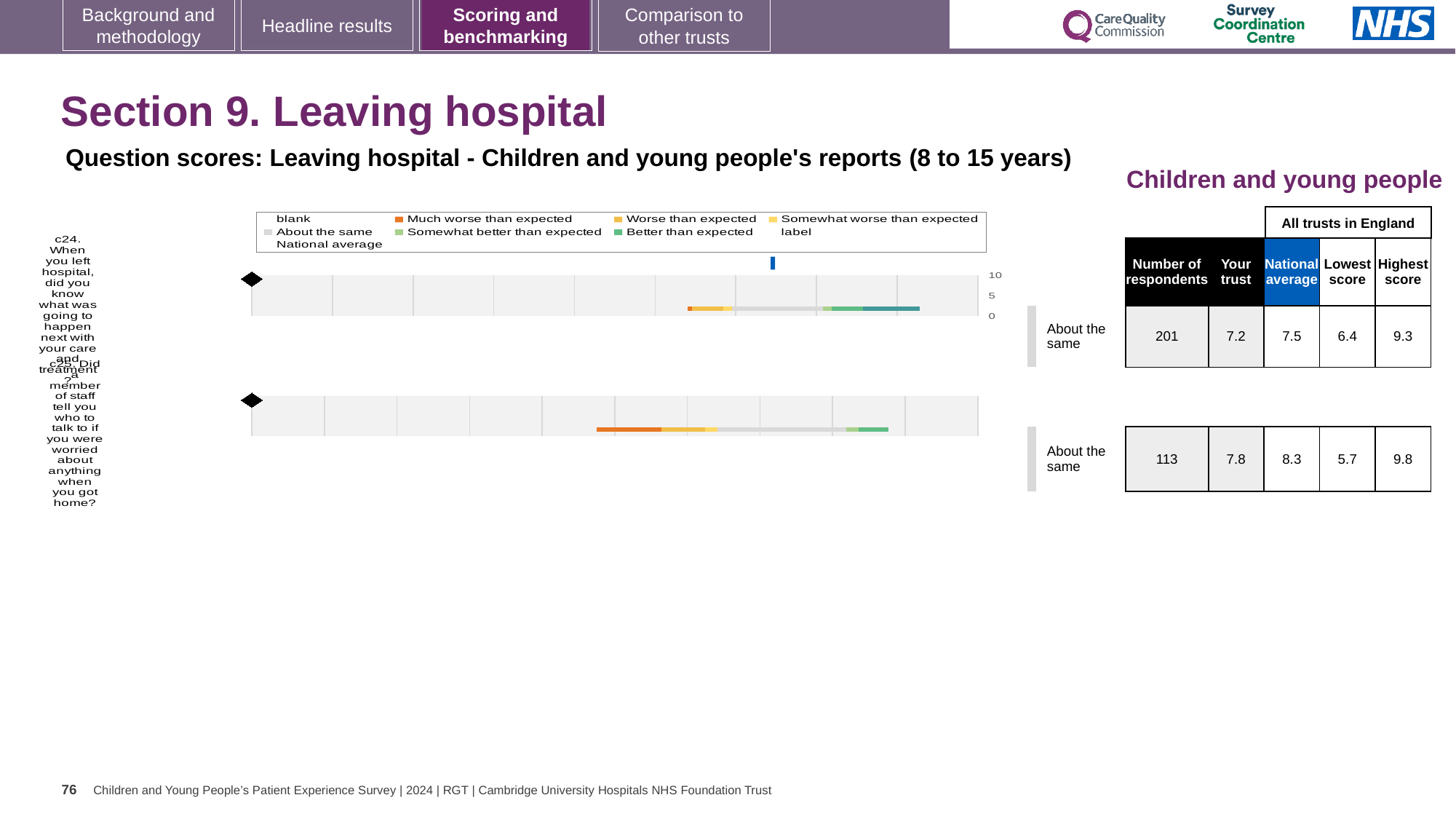
How many questions (bars) are plotted in the chart? 2 What benchmark category is shown for both c24 and c25? About the same What is the difference between the highest and lowest scores for question c24? 2.9 What is the 'Your trust' score for question c24? 7.2 What kind of chart is used to show the question scores for c24 and c25? bar chart By how much does the national average exceed the 'Your trust' score for question c25? 0.5 What is the lowest score among all trusts in England for question c24? 6.4 Which question has the higher 'Your trust' score, c24 or c25? c25 What is the national average score for question c25? 8.3 What colour represents 'Much worse than expected' in the chart legend? orange How many entries does the chart legend list? 9 How many respondents answered question c25? 113